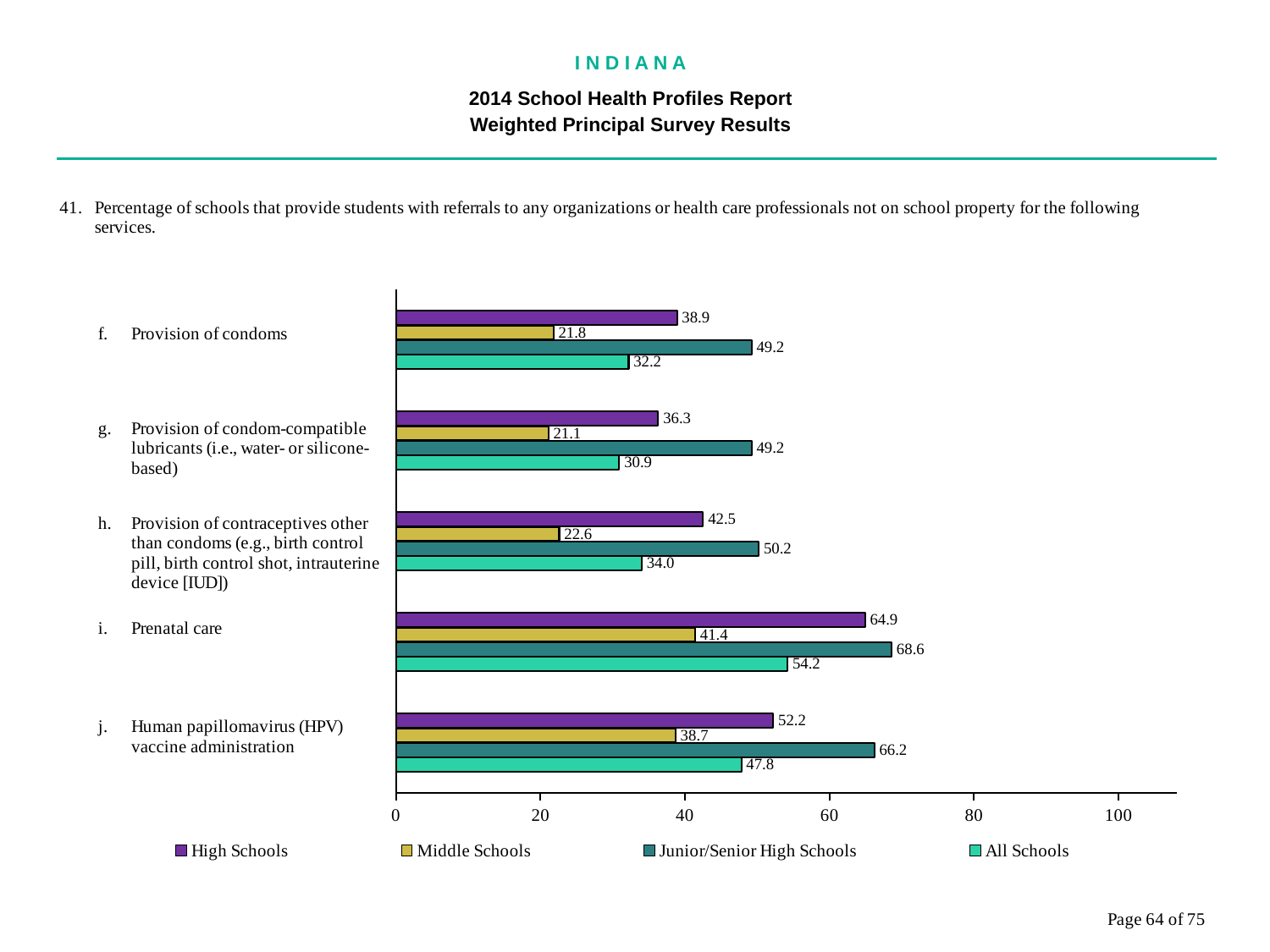
What is the difference between the Junior/Senior High Schools and Middle Schools values for Prenatal care? 27.2 What kind of chart is shown on the slide? Bar chart Which service has the lowest value for Middle Schools? Provision of condom-compatible lubricants (i.e., water- or silicone-based) Which series is shown in purple in the legend? High Schools How many series does the legend list? 4 Which is larger for Human papillomavirus (HPV) vaccine administration: the High Schools value or the All Schools value? High Schools How many services (categories) are shown in the chart? 5 What is the value for All Schools for Provision of contraceptives other than condoms? 34.0 What is the value for Middle Schools for Provision of condoms? 21.8 What is the value for High Schools for Prenatal care? 64.9 Which service has the highest value for Junior/Senior High Schools? Prenatal care What is the value for Junior/Senior High Schools for Human papillomavirus (HPV) vaccine administration? 66.2